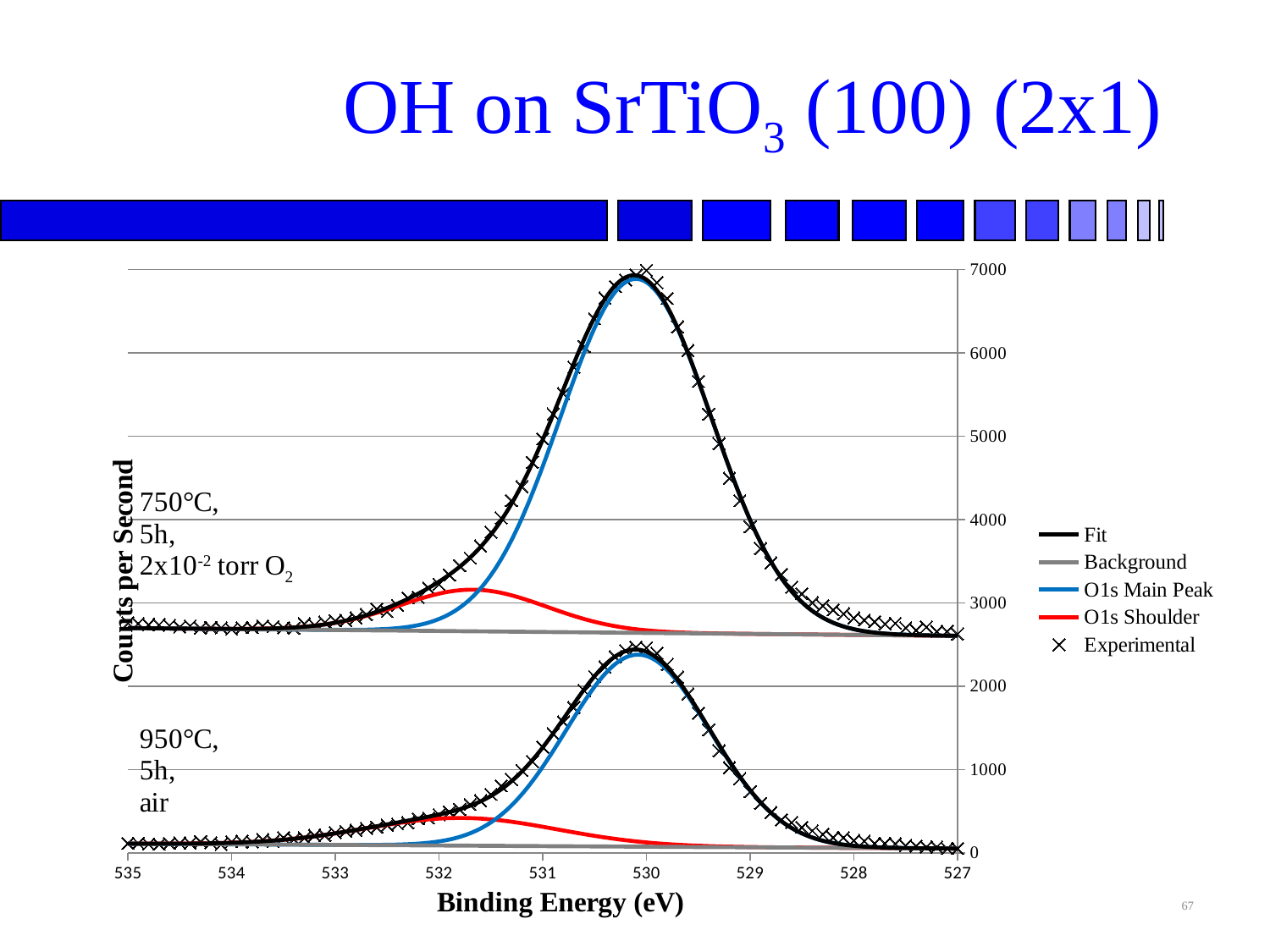
What is the highest value shown on the y axis of the chart? 7000 What is the title of the y axis of the chart? Counts per Second Is the peak value of the 750°C, 5h, 2x10-2 torr O2 spectrum greater or less than 6000? greater Which legend entry is plotted with a red line? O1s Shoulder Is the value of the 950°C spectrum at 527 eV greater or less than 1000? less What kind of chart is shown on the slide? line chart How many entries does the chart legend list? 5 Which spectrum reaches a higher peak in counts per second, the 750°C one or the 950°C one? 750°C Is the peak value of the 950°C, 5h, air spectrum greater or less than 3000? less